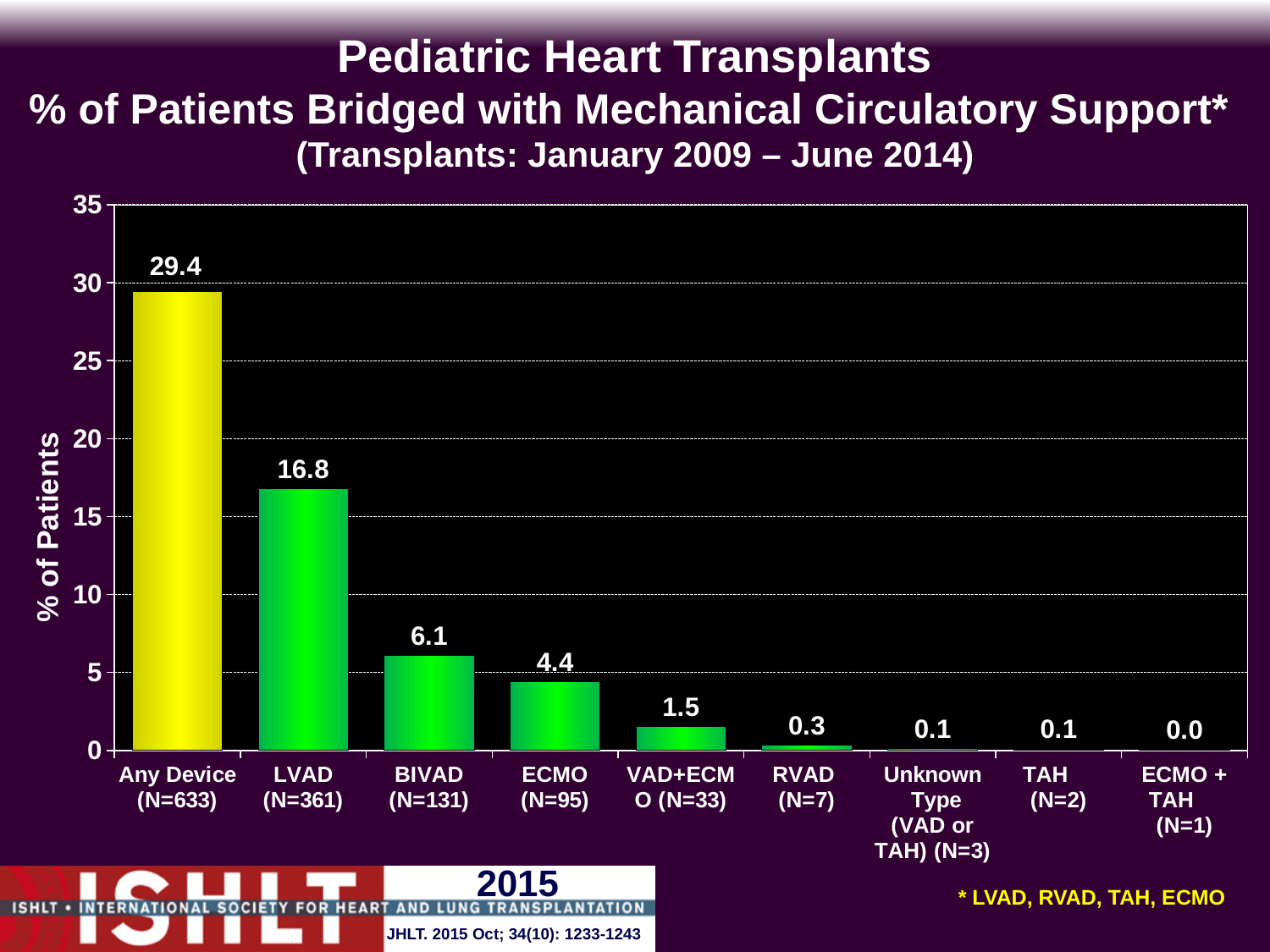
What is the difference in % of patients between LVAD and BIVAD? 10.7 Which has a higher % of patients, BIVAD or ECMO? BIVAD Is the value for LVAD greater or less than 15? greater Which category has the highest % of patients? Any Device (N=633) What is the % of patients bridged with VAD+ECMO (N=33)? 1.5 How many categories are shown on the x axis? 9 What is the % of patients bridged with ECMO (N=95)? 4.4 What is the % of patients bridged with LVAD (N=361)? 16.8 Which category has the lowest % of patients? ECMO + TAH (N=1) What is the label of the y axis? % of Patients What is the % of patients bridged with any device (N=633)? 29.4 What kind of chart is shown on the slide? Bar chart